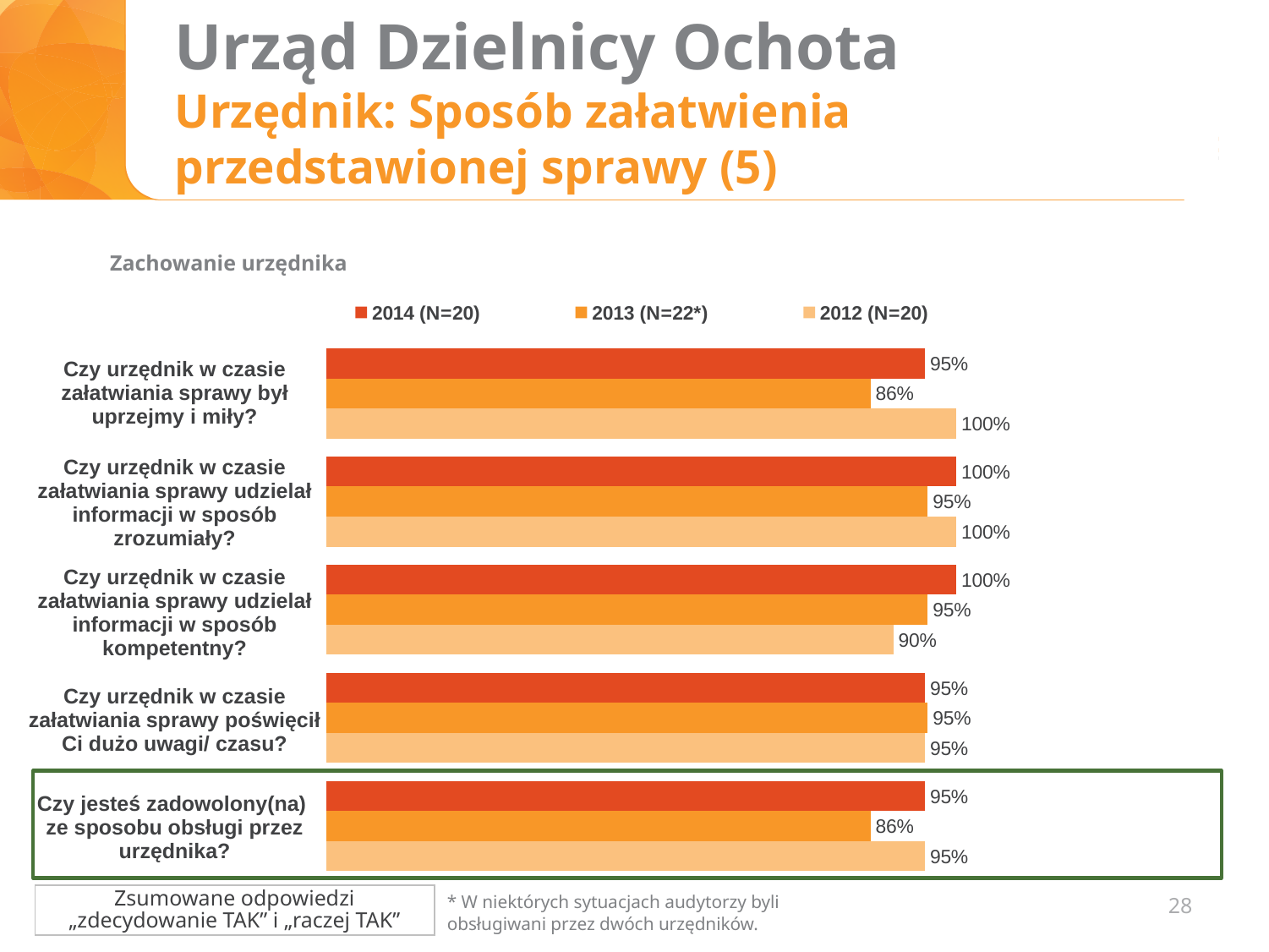
For "Czy jesteś zadowolony(na) ze sposobu obsługi przez urzędnika?", is the 2014 value or the 2013 value larger? 2014 What is the 2013 value for "Czy jesteś zadowolony(na) ze sposobu obsługi przez urzędnika?"? 86% What is the difference between the 2012 and 2013 values for "Czy urzędnik w czasie załatwiania sprawy był uprzejmy i miły?"? 14 percentage points Which year has the highest value for "Czy urzędnik w czasie załatwiania sprawy udzielał informacji w sposób kompetentny?"? 2014 (N=20) What type of chart is shown on the slide? Bar chart Which year has the lowest value for "Czy urzędnik w czasie załatwiania sprawy był uprzejmy i miły?"? 2013 (N=22*) What is the 2014 value for "Czy urzędnik w czasie załatwiania sprawy był uprzejmy i miły?"? 95% How many series does the legend list? 3 What is the 2014 value for "Czy urzędnik w czasie załatwiania sprawy udzielał informacji w sposób zrozumiały?"? 100% What is the difference between the 2014 and 2012 values for "Czy urzędnik w czasie załatwiania sprawy udzielał informacji w sposób kompetentny?"? 10 percentage points How many question categories are shown in the chart? 5 What is the 2012 value for "Czy urzędnik w czasie załatwiania sprawy udzielał informacji w sposób kompetentny?"? 90%